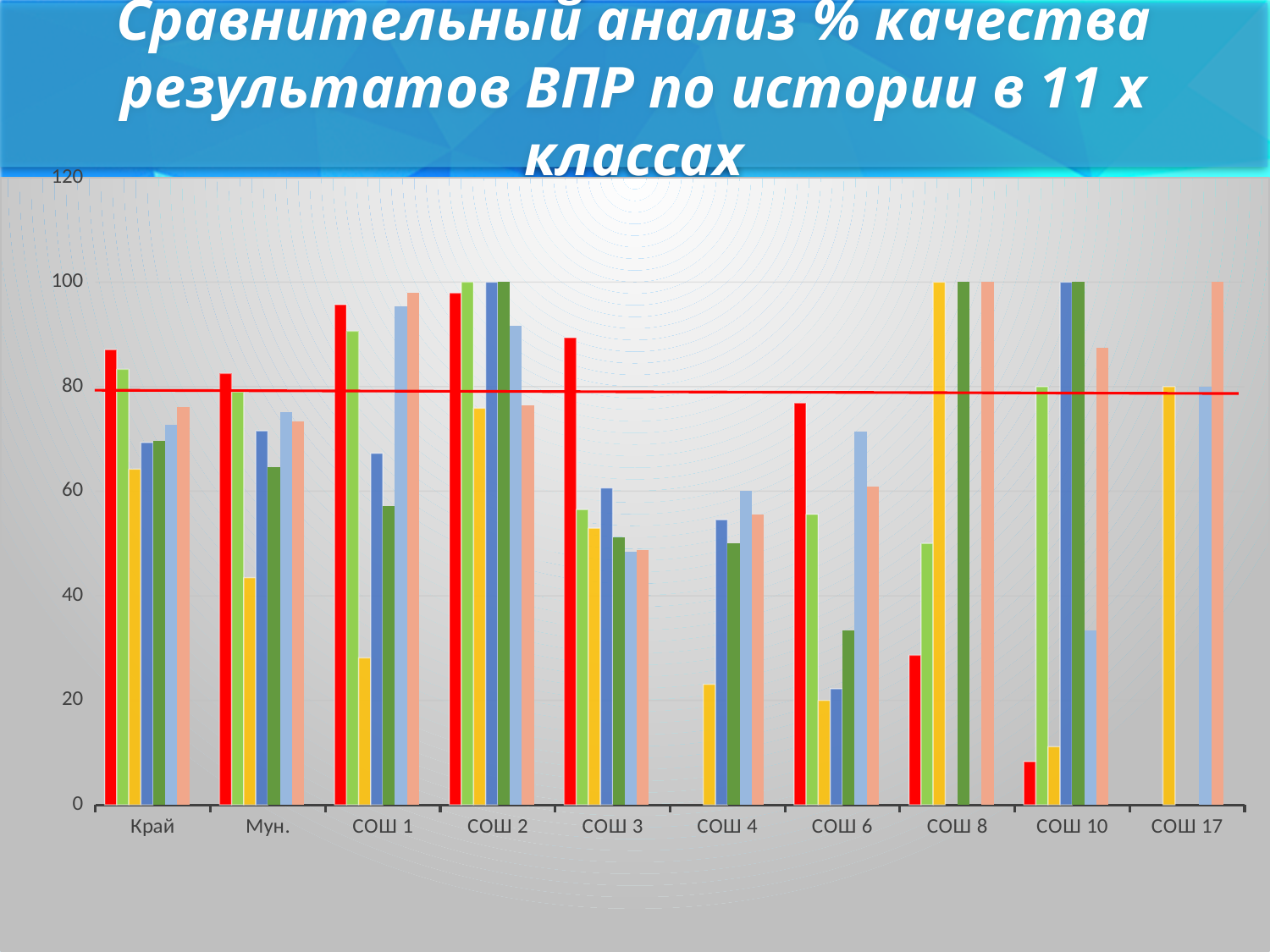
Is the value of the red bar for Край greater or less than 80? greater What colour is the horizontal reference line drawn across the chart? red Is the value of the red bar for СОШ 10 greater or less than 20? less How many categories are shown along the x axis of the chart? 10 What is the value of the salmon (light orange) bar for СОШ 17? 100 Which is larger: the red bar for СОШ 2 or the red bar for СОШ 6? СОШ 2 Is the value of the dark green bar for СОШ 3 greater or less than 60? less What is the value of the yellow bar for СОШ 8? 100 Among the categories that have a red bar, which one has the lowest red bar? СОШ 10 What kind of chart is shown on the slide? bar chart